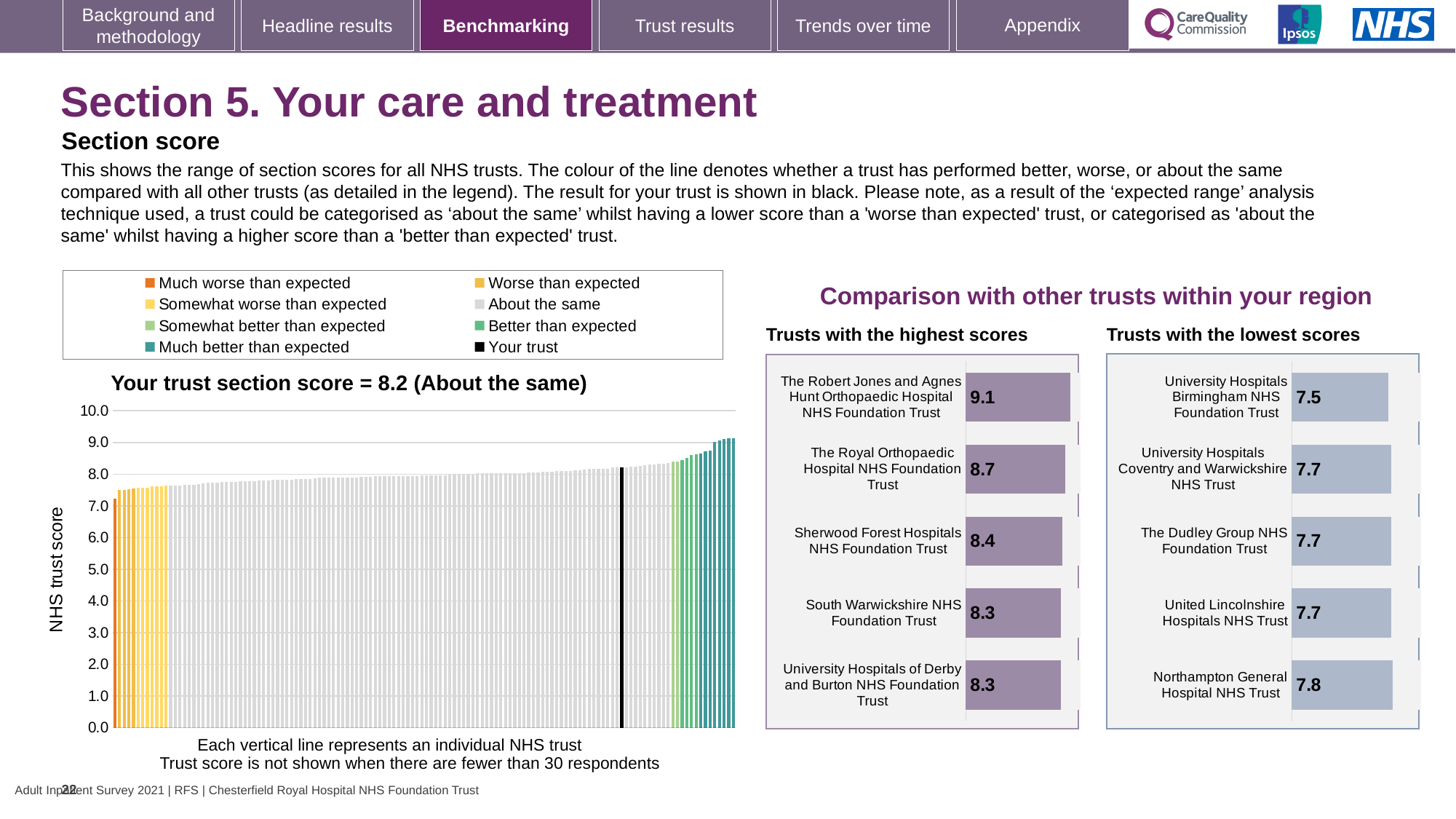
In the 'Trusts with the lowest scores' chart, which has the larger score: Northampton General Hospital NHS Trust or University Hospitals Birmingham NHS Foundation Trust? Northampton General Hospital NHS Trust In the 'Your trust section score' chart, do the bars rise or fall from left to right? rise In the 'Your trust section score' chart, what is the section score for your trust? 8.2 In the 'Trusts with the highest scores' chart, what is the difference between the scores of The Robert Jones and Agnes Hunt Orthopaedic Hospital NHS Foundation Trust and The Royal Orthopaedic Hospital NHS Foundation Trust? 0.4 In the 'Trusts with the highest scores' chart, which trust has the highest score? The Robert Jones and Agnes Hunt Orthopaedic Hospital NHS Foundation Trust What kind of chart is the 'Your trust section score' chart on the left of the slide? bar chart How many entries does the legend above the 'Your trust section score' chart list? 8 How many trusts are shown in the 'Trusts with the lowest scores' chart? 5 In the 'Trusts with the highest scores' chart, what is the score for The Robert Jones and Agnes Hunt Orthopaedic Hospital NHS Foundation Trust? 9.1 In the 'Your trust section score' chart, what colour is the bar representing your trust? black In the 'Your trust section score' chart, is the value of the leftmost (orange) bar greater or less than 8.0? less In the 'Trusts with the lowest scores' chart, which trust has the lowest score? University Hospitals Birmingham NHS Foundation Trust